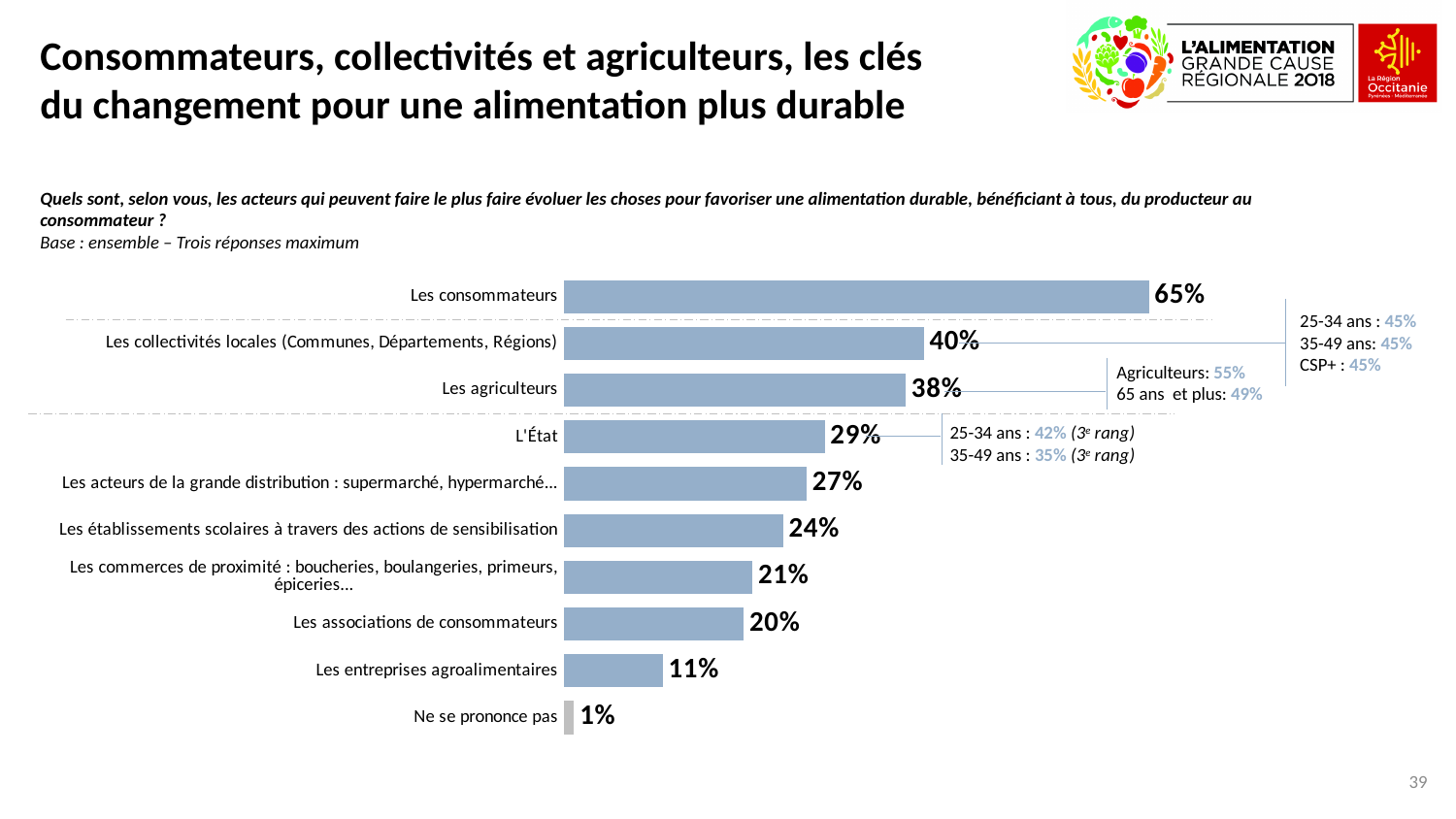
What is the difference between the values for "Les consommateurs" and "Les collectivités locales (Communes, Départements, Régions)"? 25% What is the value for "Les entreprises agroalimentaires"? 11% What is the value for "L'État"? 29% What is the difference between the values for "Les agriculteurs" and "L'État"? 9% Which is larger: the value for "Les établissements scolaires à travers des actions de sensibilisation" or the value for "Les associations de consommateurs"? Les établissements scolaires à travers des actions de sensibilisation What is the value for "Les agriculteurs"? 38% Which category has the lowest value? Ne se prononce pas How many categories are shown in the chart? 10 What is the value for "Les consommateurs"? 65% What kind of chart is shown on the slide? Bar chart What is the value for "Les commerces de proximité : boucheries, boulangeries, primeurs, épiceries…"? 21% Which category has the highest value? Les consommateurs